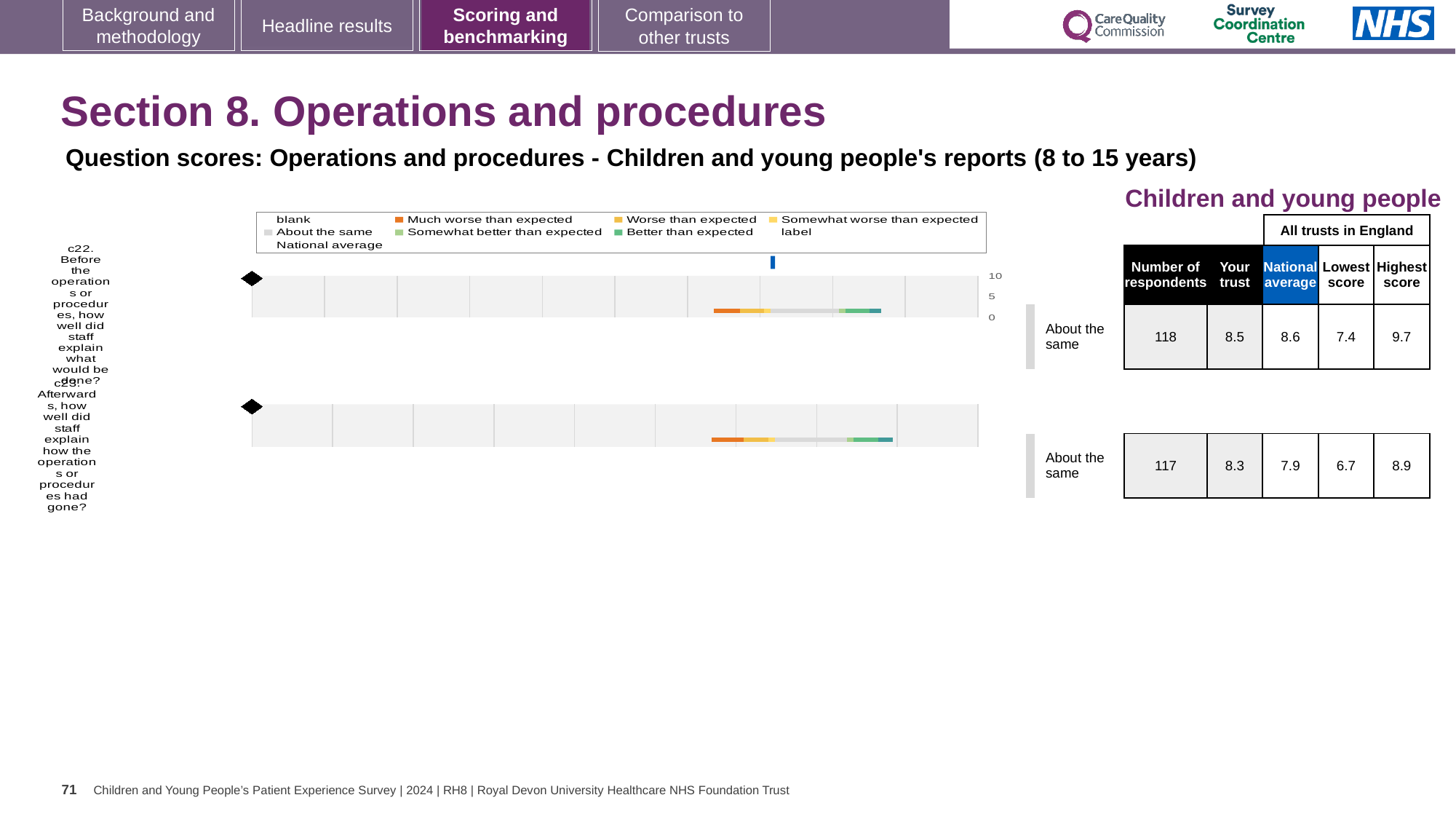
What benchmark category is the trust placed in for question c22? About the same What kind of chart is used to show the question scores on this slide? bar chart How many respondents answered question c22? 118 What is the lowest score across all trusts in England for question c23? 6.7 Which legend entry is shown in orange? Much worse than expected For question c22, which is larger: the trust's score or the national average? National average What is the national average score for question c23 (Afterwards, how well did staff explain how the operations or procedures had gone?)? 7.9 What is the difference between the highest and lowest scores for question c23? 2.2 How many questions (chart rows) are plotted on this slide? 2 For question c23, which is larger: the trust's score or the national average? Your trust What is the 'Your trust' score for question c22 (Before the operations or procedures, how well did staff explain what would be done?)? 8.5 What is the highest score across all trusts in England for question c22? 9.7